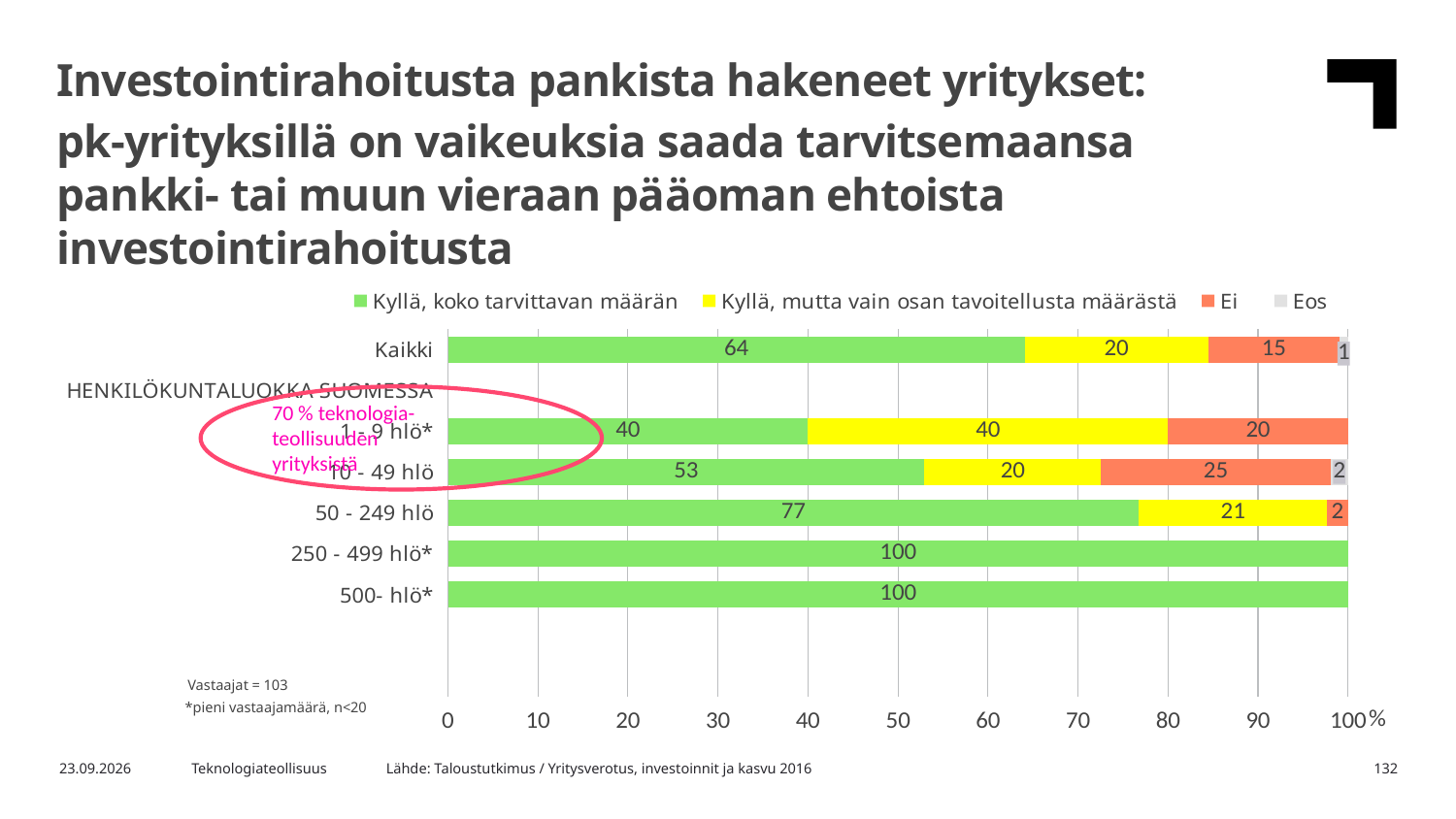
What is the value of 'Kyllä, koko tarvittavan määrän' for the 250 - 499 hlö* category? 100 What is the value of 'Kyllä, mutta vain osan tavoitellusta määrästä' for the 50 - 249 hlö category? 21 What is the value of 'Kyllä, koko tarvittavan määrän' for the Kaikki category? 64 Which category has the lowest value for 'Kyllä, koko tarvittavan määrän'? 1 - 9 hlö* How many series does the legend list? 4 What is the total of the stacked bar for the 10 - 49 hlö category? 100 How many categories are shown on the vertical axis of the chart? 6 What is the difference between the 'Kyllä, koko tarvittavan määrän' values for 50 - 249 hlö and 10 - 49 hlö? 24 What kind of chart is shown on the slide? Stacked bar chart Which is larger: the 'Ei' value for 1 - 9 hlö* or for Kaikki? 1 - 9 hlö* What colour represents the 'Ei' series in the chart? Orange What is the value of 'Ei' for the 10 - 49 hlö category? 25